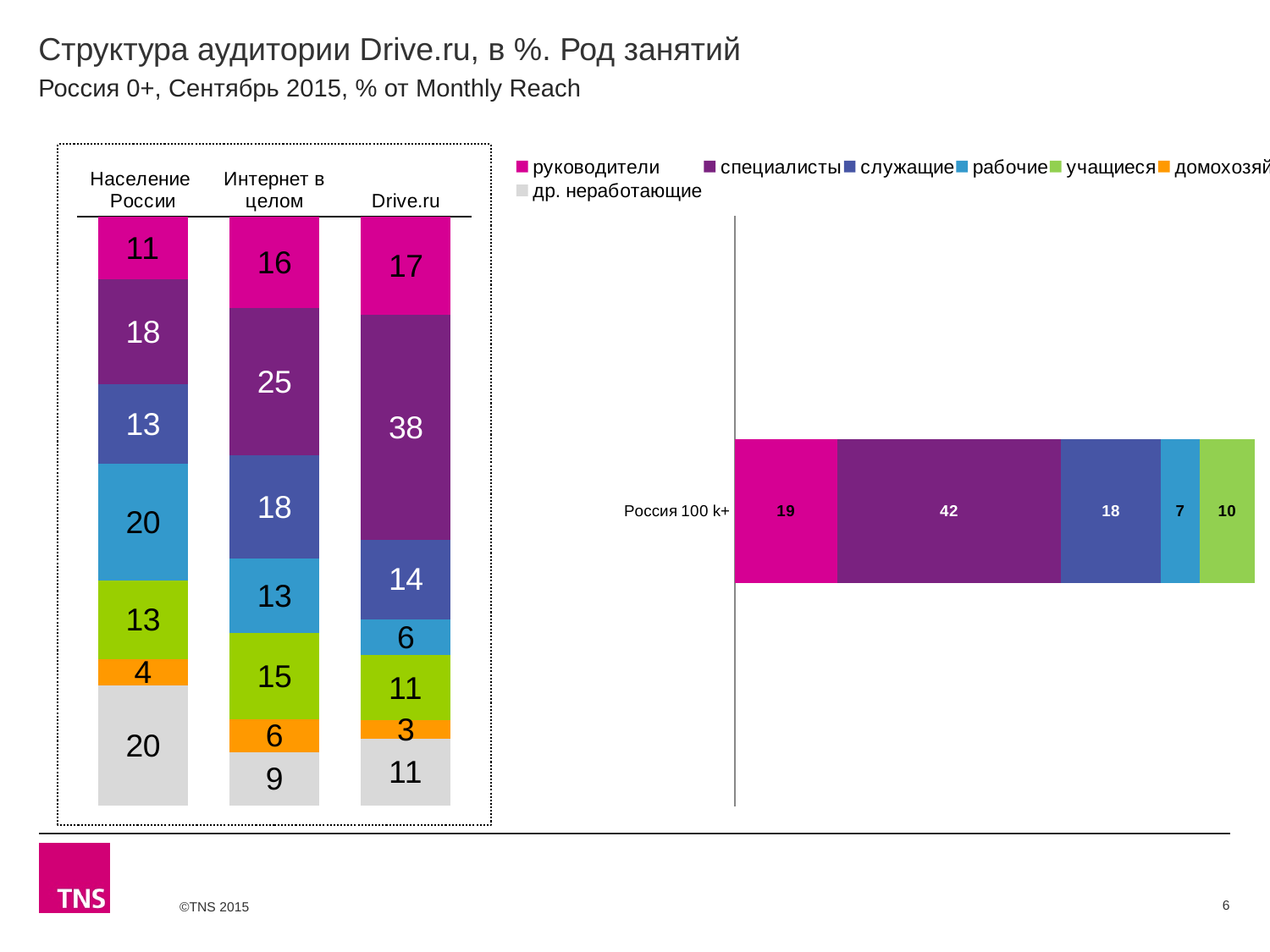
In the left chart, what is the value of the специалисты (purple) segment for Drive.ru? 38 In the left chart, which of the three bars has the smallest рабочие (light blue) segment? Drive.ru In the left chart, what is the value of the bottom grey segment (др. неработающие) for Интернет в целом? 9 In the right chart, what is the value of the специалисты (purple) segment for Россия 100 k+? 42 In the left chart, what is the difference between the специалисты value for Drive.ru and for Интернет в целом? 13 In the left chart, what is the value of the руководители (pink) segment for Население России? 11 How many bars are shown in the left chart? 3 In the left chart, which of the three bars has the largest специалисты (purple) segment? Drive.ru What type of chart is the right chart? Stacked horizontal bar chart In the right chart, what is the value of the рабочие (light blue) segment for Россия 100 k+? 7 In the left chart, is the учащиеся (green) value larger for Интернет в целом or for Drive.ru? Интернет в целом